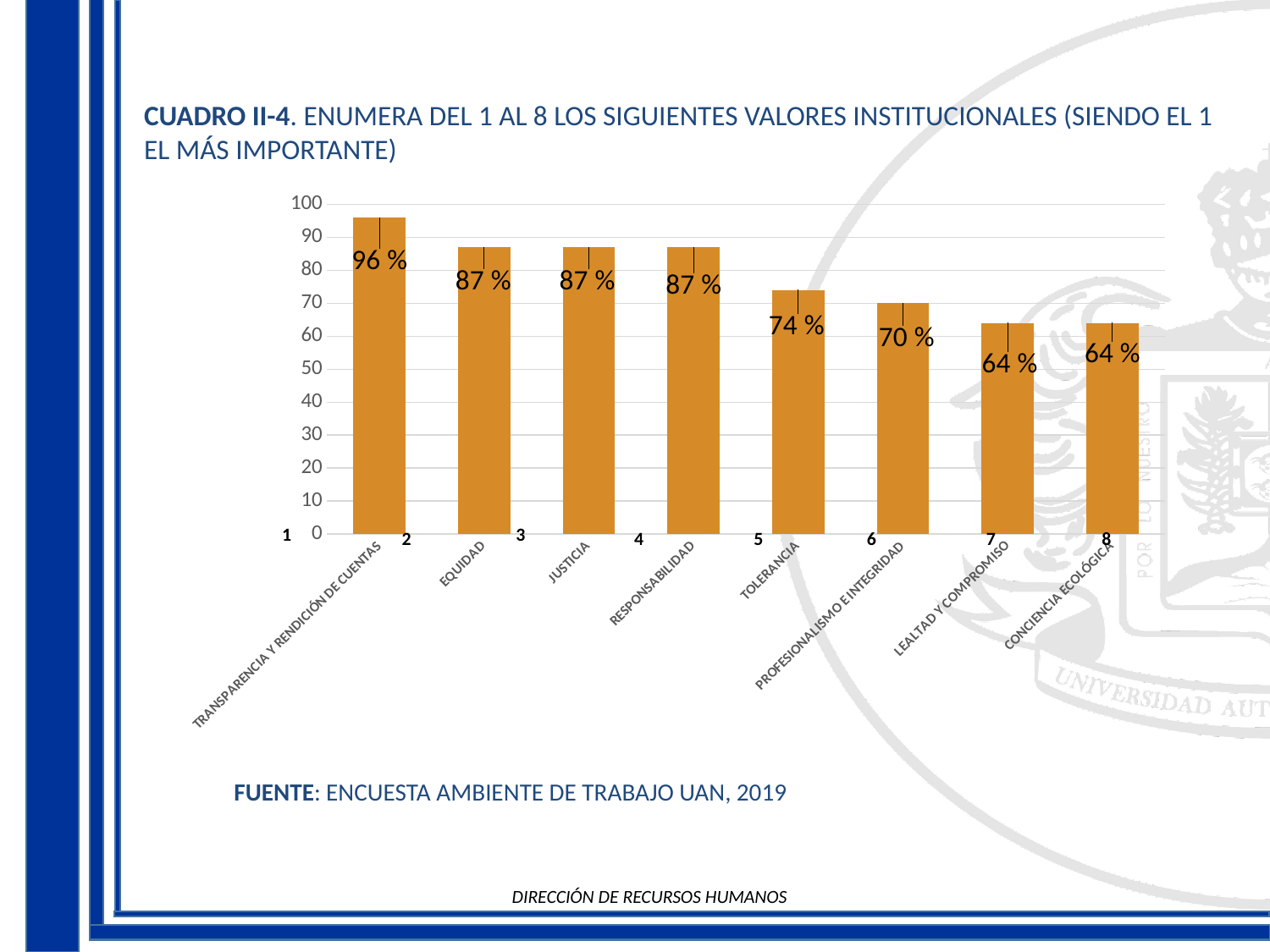
What is the difference between the values for TRANSPARENCIA Y RENDICIÓN DE CUENTAS and EQUIDAD? 9 % What is the value for CONCIENCIA ECOLÓGICA? 64 % Do the values generally rise or fall from left to right along the x axis? fall What kind of chart is shown on the slide? bar chart Is the value for TOLERANCIA greater or less than 80? less Which is larger, the value for JUSTICIA or the value for PROFESIONALISMO E INTEGRIDAD? JUSTICIA What is the value for TRANSPARENCIA Y RENDICIÓN DE CUENTAS? 96 % Which category has the highest value? TRANSPARENCIA Y RENDICIÓN DE CUENTAS What is the difference between the values for TOLERANCIA and LEALTAD Y COMPROMISO? 10 % What is the value for TOLERANCIA? 74 % How many categories are shown on the x axis? 8 What is the value for PROFESIONALISMO E INTEGRIDAD? 70 %